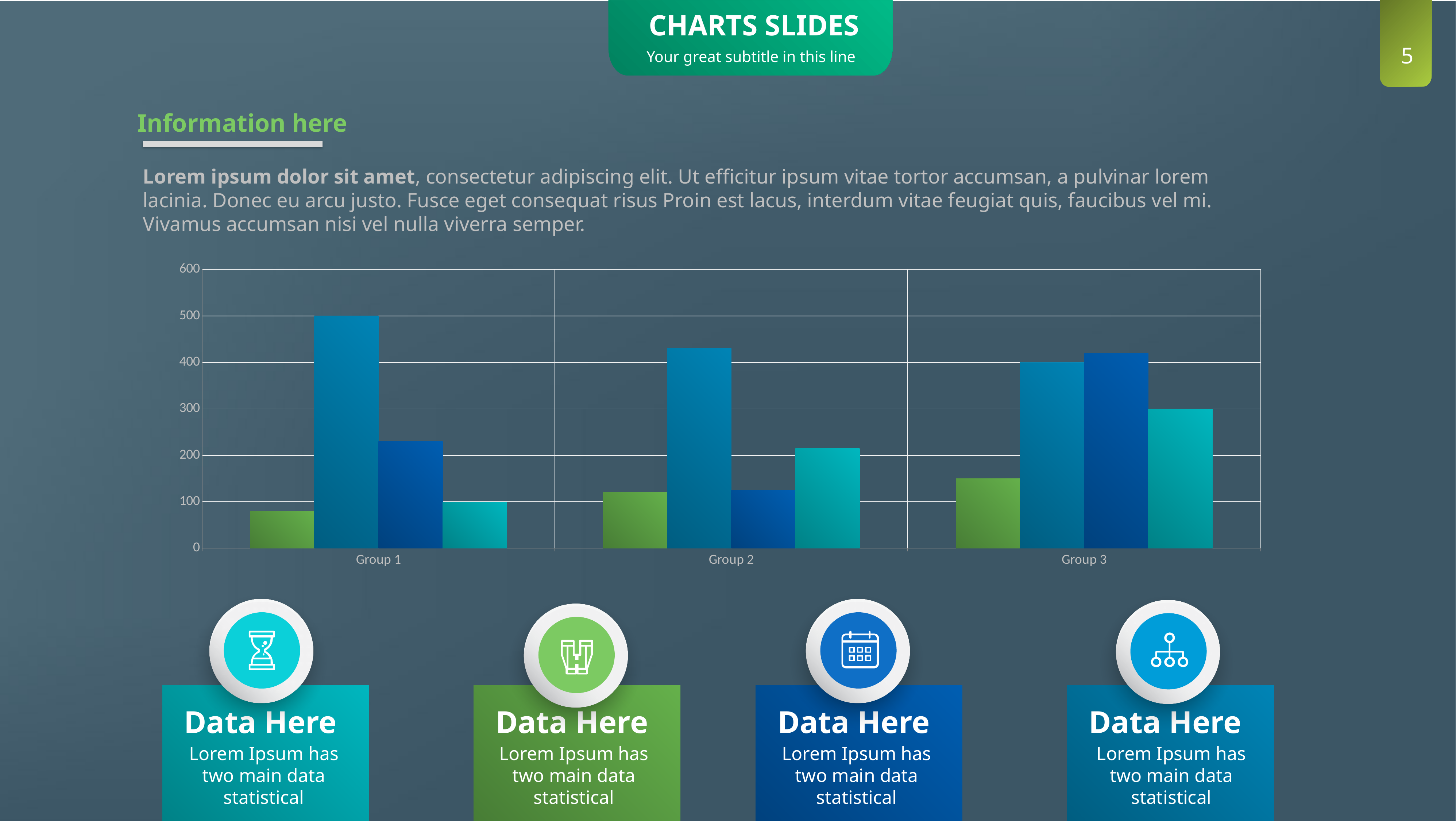
What is the value of the blue (second) bar in Group 3? 400 Is the value of the green bar in Group 1 greater or less than 100? less What is the value of the tallest (blue) bar in Group 1? 500 Which group contains the tallest bar in the chart? Group 1 Do the green (first) bars rise or fall from Group 1 to Group 3? rise What is the highest value shown on the y axis of the chart? 600 How many groups are shown on the x axis of the chart? 3 What type of chart is shown on the slide? bar chart What is the difference between the blue bar (500) and the teal bar (100) in Group 1? 400 Is the value of the blue (second) bar in Group 2 greater or less than 400? greater What is the value of the teal (rightmost) bar in Group 3? 300 Which is larger: the blue (second) bar in Group 1 or the blue (second) bar in Group 2? Group 1